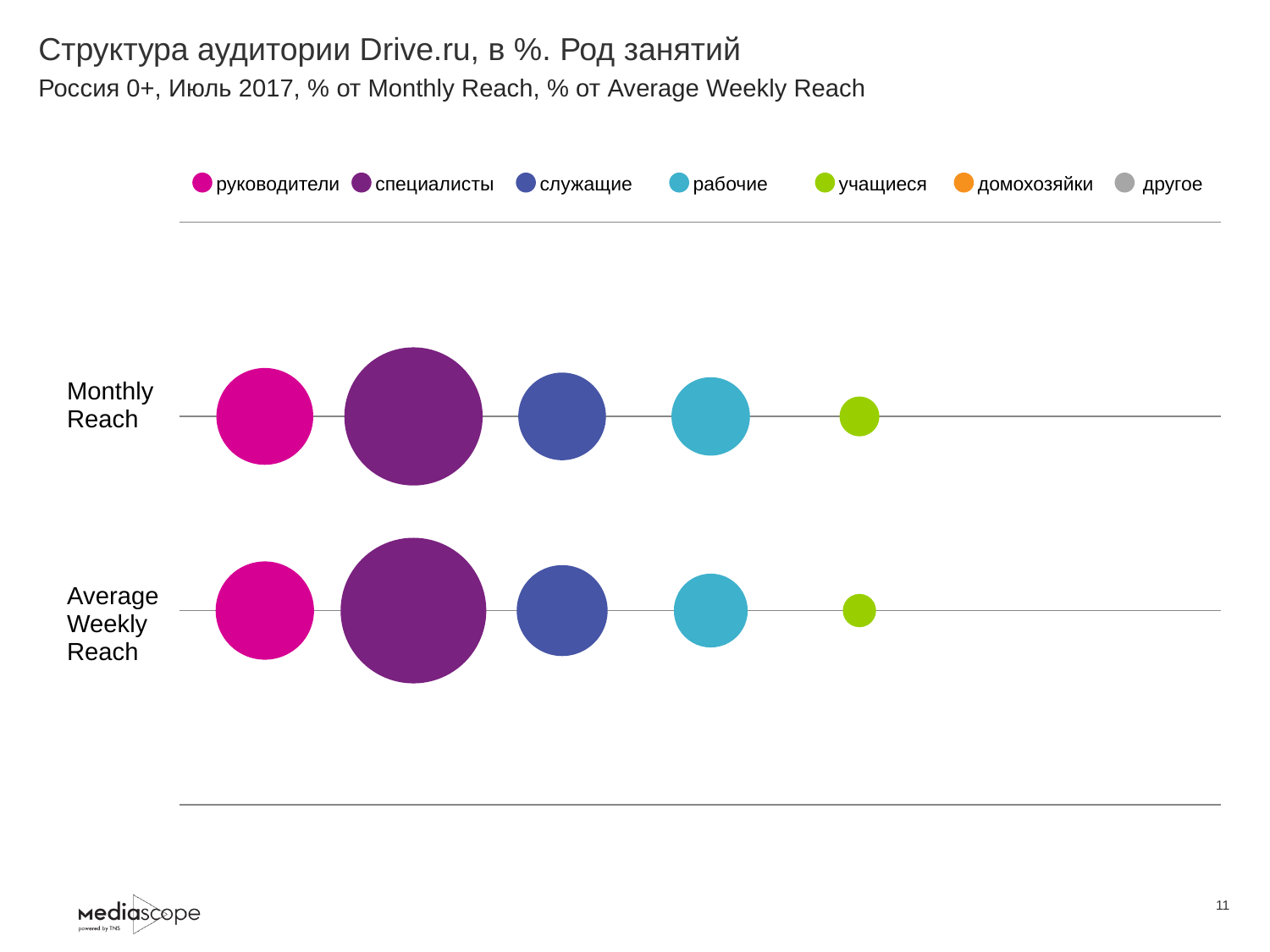
How many series does the legend list? 7 Among the visible bubbles in the Monthly Reach row, which occupation group has the smallest? учащиеся What colour is used for the series 'рабочие' in the legend? light blue In the Monthly Reach row, which bubble is larger: специалисты or служащие? специалисты Which occupation group has the largest bubble in the Monthly Reach row? специалисты Which occupation group has the largest bubble in the Average Weekly Reach row? специалисты Among the visible bubbles in the Average Weekly Reach row, which occupation group has the smallest? учащиеся In the Monthly Reach row, which bubble is larger: рабочие or учащиеся? рабочие What is the title of the chart on the slide? Структура аудитории Drive.ru, в %. Род занятий In the Average Weekly Reach row, which bubble is larger: руководители or учащиеся? руководители How many rows (categories) are plotted on the chart? 2 What kind of chart is shown on the slide? bubble chart